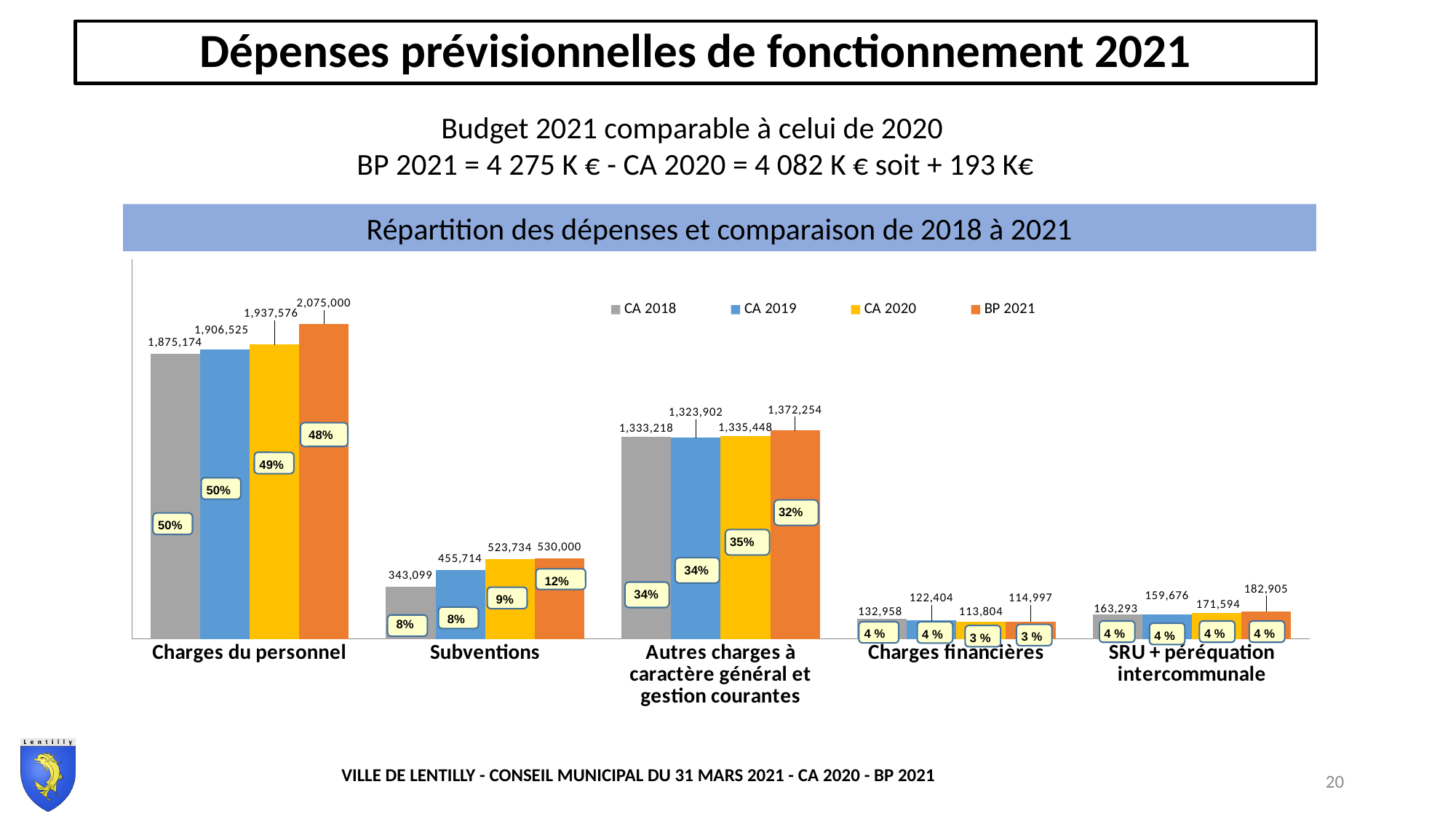
Which category has the highest BP 2021 value? Charges du personnel What kind of chart is shown on the slide? Bar chart What is the BP 2021 value for Charges du personnel? 2,075,000 How many series does the legend list? 4 Which category has the lowest CA 2019 value? Charges financières Which is larger for SRU + péréquation intercommunale: the CA 2018 value or the CA 2019 value? CA 2018 What is the difference between the BP 2021 and CA 2020 values for Charges du personnel? 137,424 Do the values for Subventions rise or fall from CA 2018 to BP 2021? Rise What is the CA 2020 value for Charges financières? 113,804 How many categories are shown on the x axis? 5 What is the CA 2018 value for Subventions? 343,099 What percentage label is shown on the BP 2021 bar for Subventions? 12%